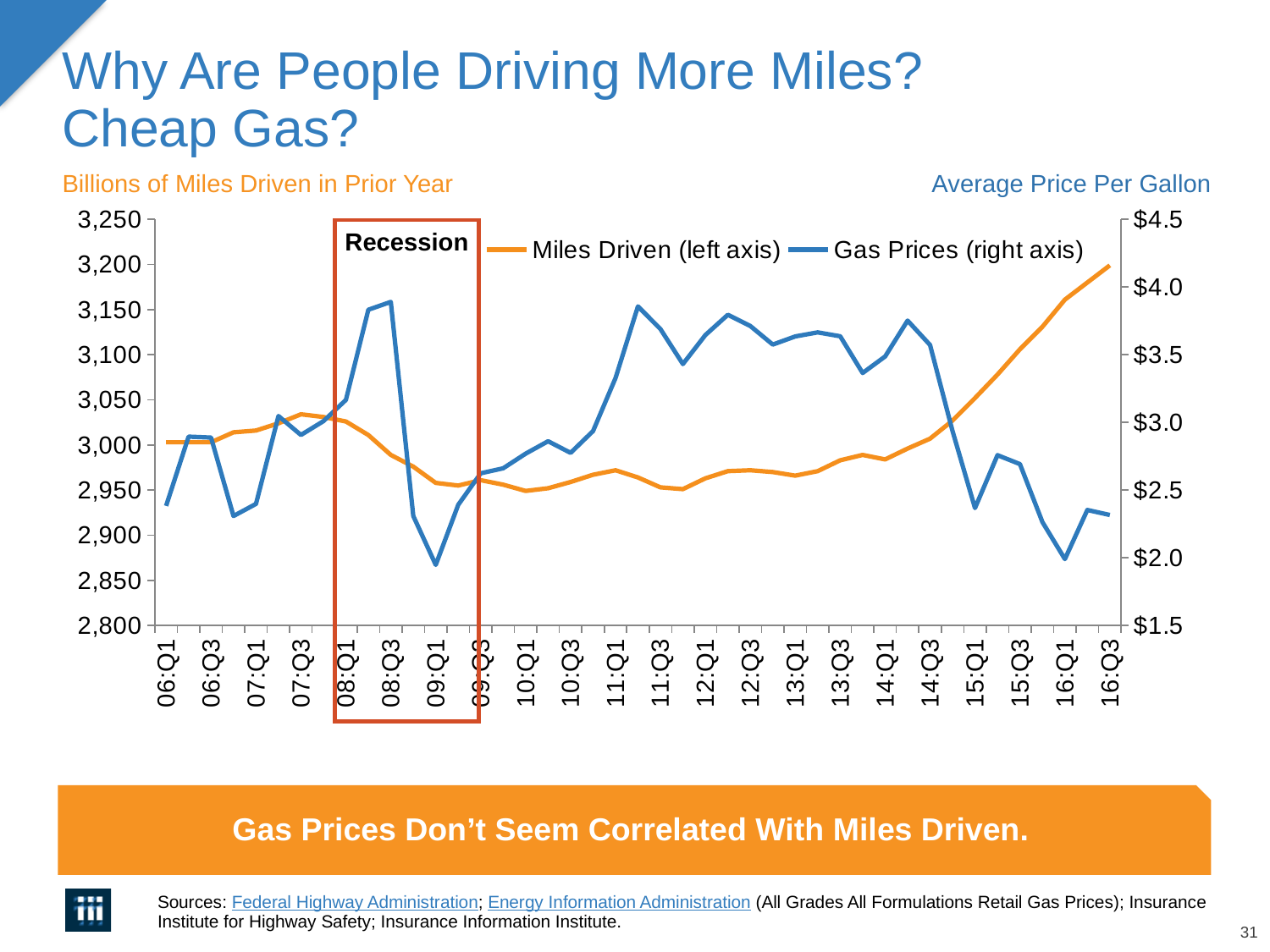
Is the Gas Prices value at 15:Q1 greater or less than $2.5? less Is the Gas Prices value at 09:Q1 greater or less than $2.0? less Which series is plotted against the right axis? Gas Prices Is the Miles Driven value at 16:Q3 greater or less than 3,150? greater What label is shown in the red box on the chart? Recession What kind of chart is shown on the slide? Line chart How many series does the legend list? 2 At which quarter does the Miles Driven series reach its highest value? 16:Q3 Does the Miles Driven series rise or fall from 14:Q1 to 16:Q3? rise